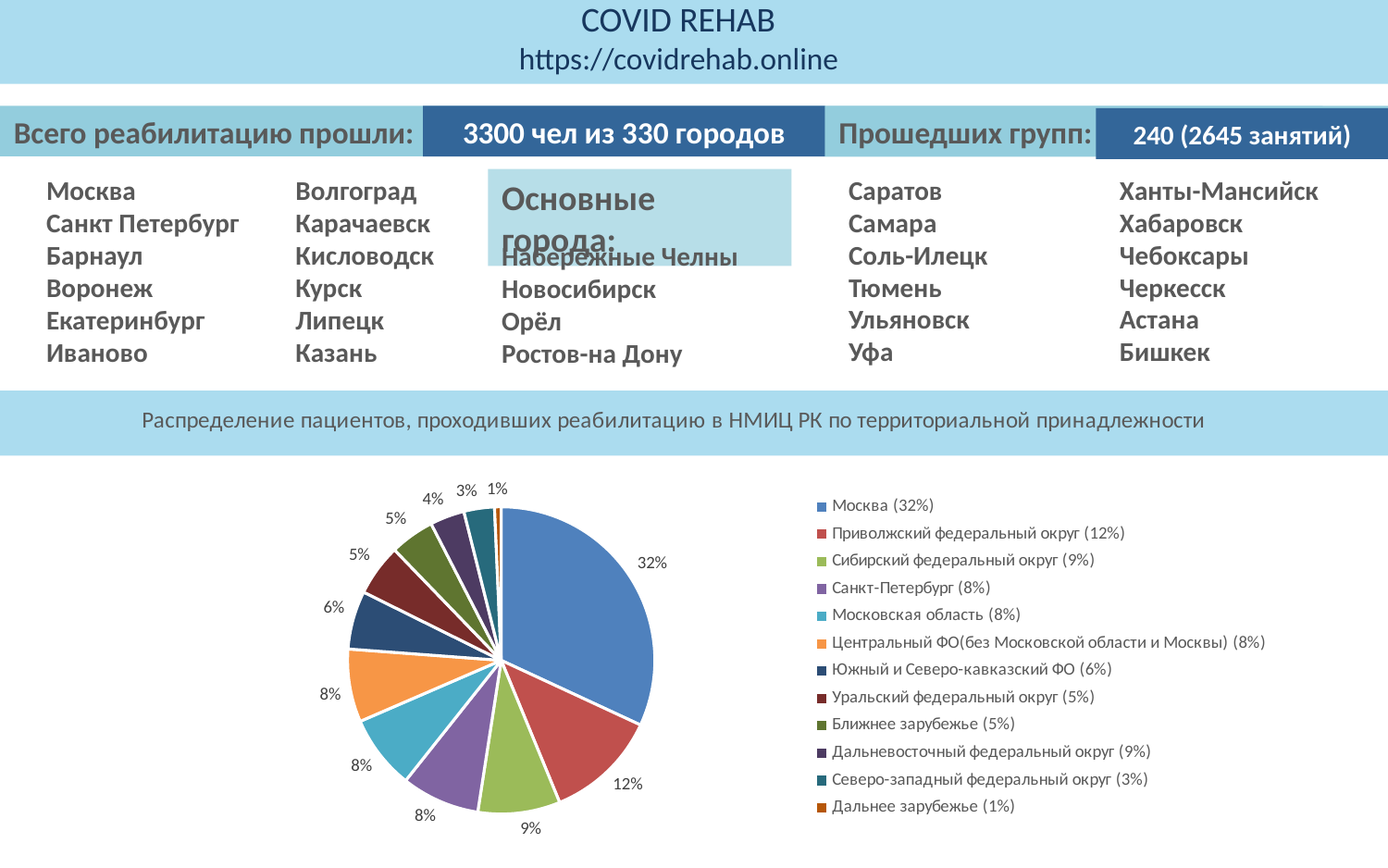
Which category has the largest share of the pie chart? Москва What kind of chart is shown on the slide? pie chart What is the value shown for Южный и Северо-кавказский ФО? 6% What is the difference in percentage points between Москва and Приволжский федеральный округ? 20 What is the title shown above the pie chart? Распределение пациентов, проходивших реабилитацию в НМИЦ РК по территориальной принадлежности What is the value shown for Сибирский федеральный округ? 9% What is the value shown for Северо-западный федеральный округ? 3% Which is larger: the share for Уральский федеральный округ or the share for Санкт-Петербург? Санкт-Петербург What share of the pie does Москва account for? 32% What is the value shown for Приволжский федеральный округ? 12% Which category has the smallest share of the pie chart? Дальнее зарубежье How many slices does the pie chart have? 12